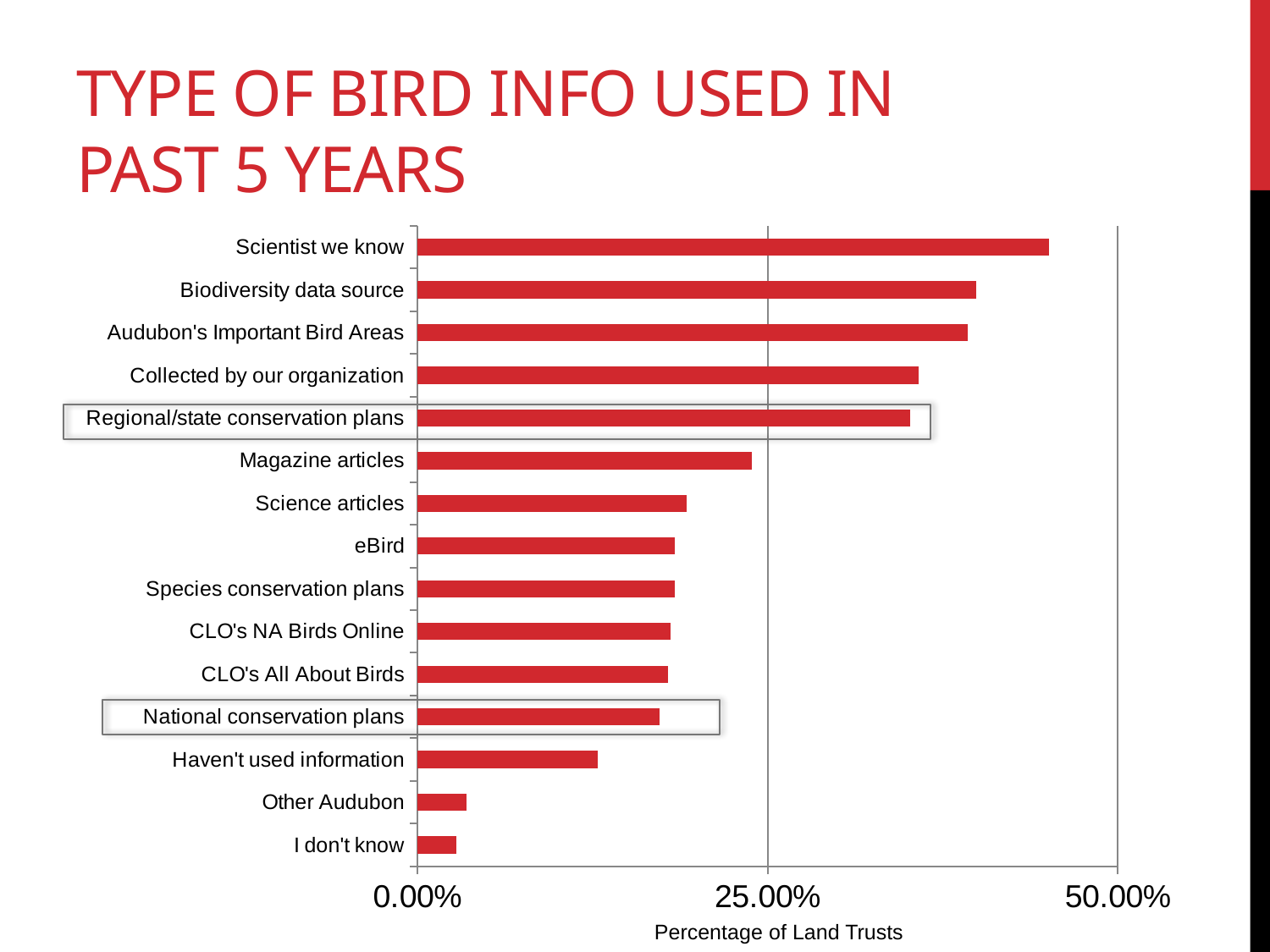
How many categories are plotted in the chart? 15 Which is larger, the value for Haven't used information or the value for Science articles? Science articles Do the bar lengths increase or decrease going from the top category to the bottom category? decrease What is the title of the horizontal axis? Percentage of Land Trusts Is the value for Science articles greater or less than 25.00%? less Is the value for Collected by our organization greater or less than 25.00%? greater Is the value for Haven't used information greater or less than 25.00%? less What kind of chart is shown on the slide? bar chart Which category has the highest percentage of land trusts? Scientist we know Which is larger, the value for Biodiversity data source or the value for Magazine articles? Biodiversity data source